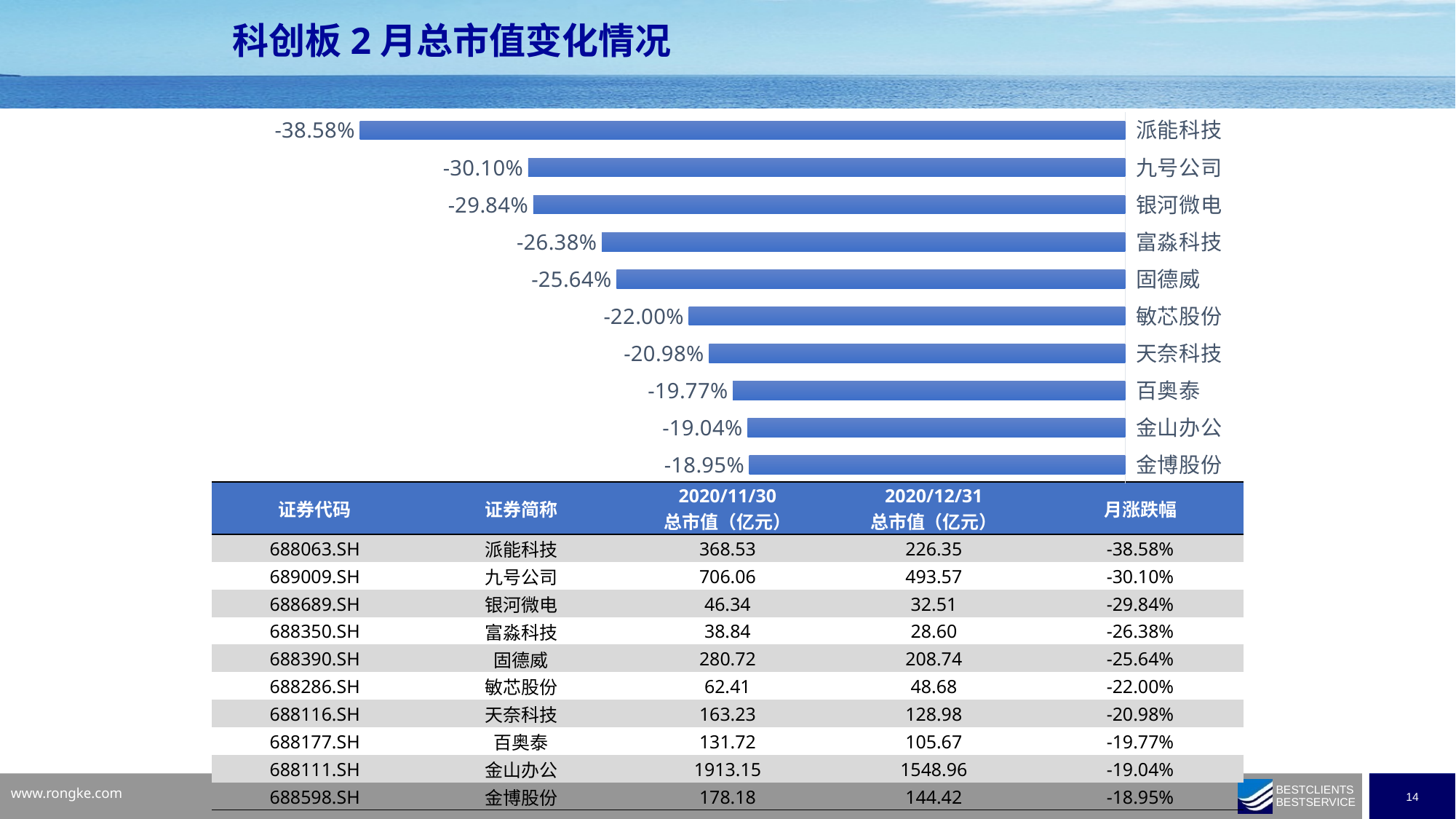
What is the value shown for 派能科技 in the bar chart? -38.58% Which has a larger (less negative) value in the bar chart, 银河微电 or 敏芯股份? 敏芯股份 What is the difference between the values for 百奥泰 and 金博股份 in the bar chart? 0.82 percentage points Which company has the lowest (most negative) value in the bar chart? 派能科技 What is the value shown for 金山办公 in the bar chart? -19.04% What is the value shown for 天奈科技 in the bar chart? -20.98% What kind of chart is shown on the slide? bar chart What is the difference between the values for 派能科技 and 九号公司 in the bar chart? 8.48 percentage points Which company has the highest (least negative) value in the bar chart? 金博股份 What is the value shown for 固德威 in the bar chart? -25.64% What is the title of the slide containing the bar chart? 科创板 2 月总市值变化情况 How many companies are plotted in the bar chart? 10